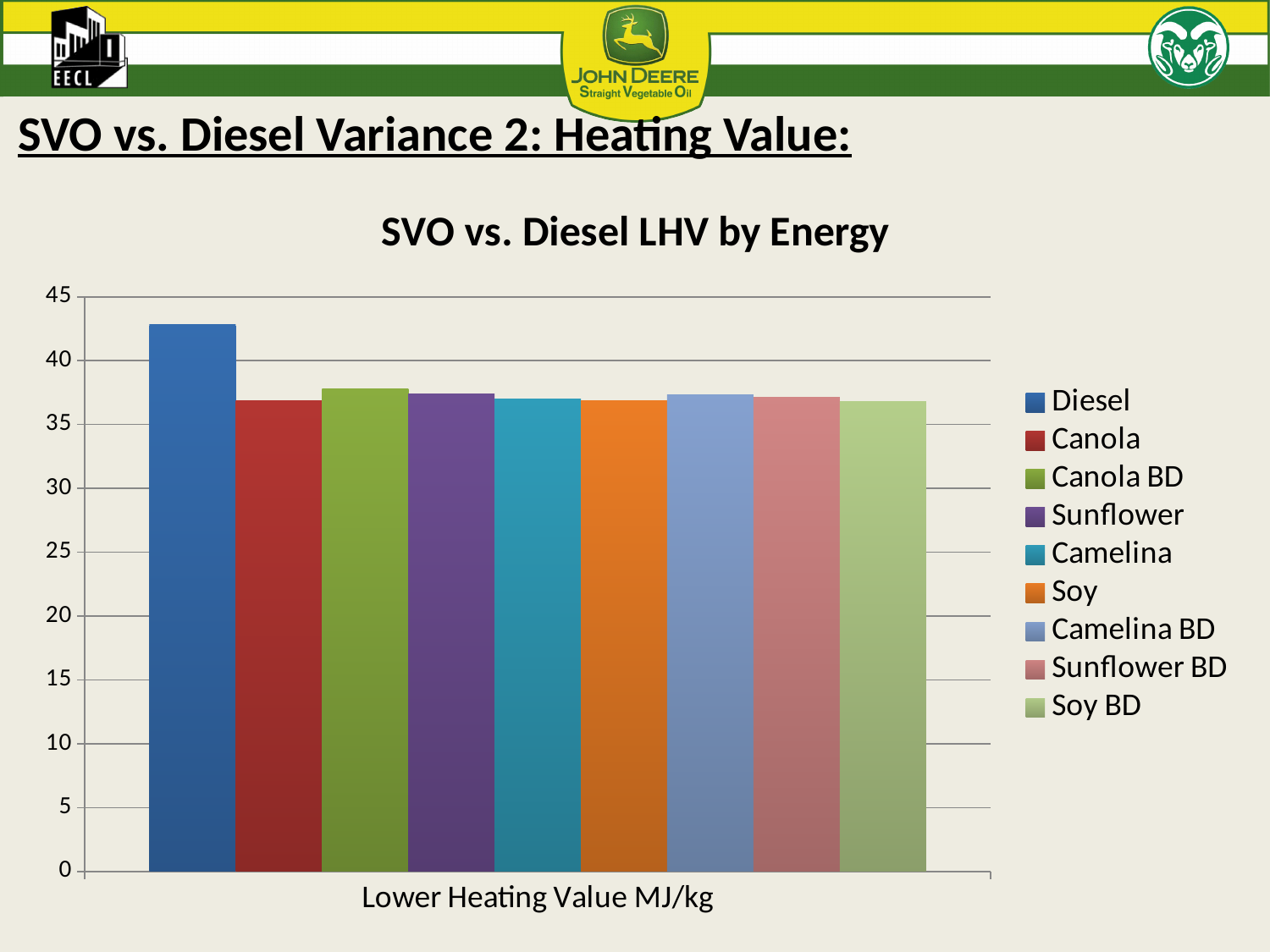
How many bars are plotted in the chart? 9 Which has a larger value, Soy BD or Diesel? Diesel Which has a larger value, Diesel or Canola? Diesel What is the label shown on the horizontal axis of the chart? Lower Heating Value MJ/kg Which fuel has the highest Lower Heating Value in the chart? Diesel Is the value for Canola greater or less than 40? less Is the value for Canola BD greater or less than 35? greater Is the value for Diesel greater or less than 40? greater What type of chart is shown on the slide? bar chart What is the title of the chart? SVO vs. Diesel LHV by Energy How many series does the legend list? 9